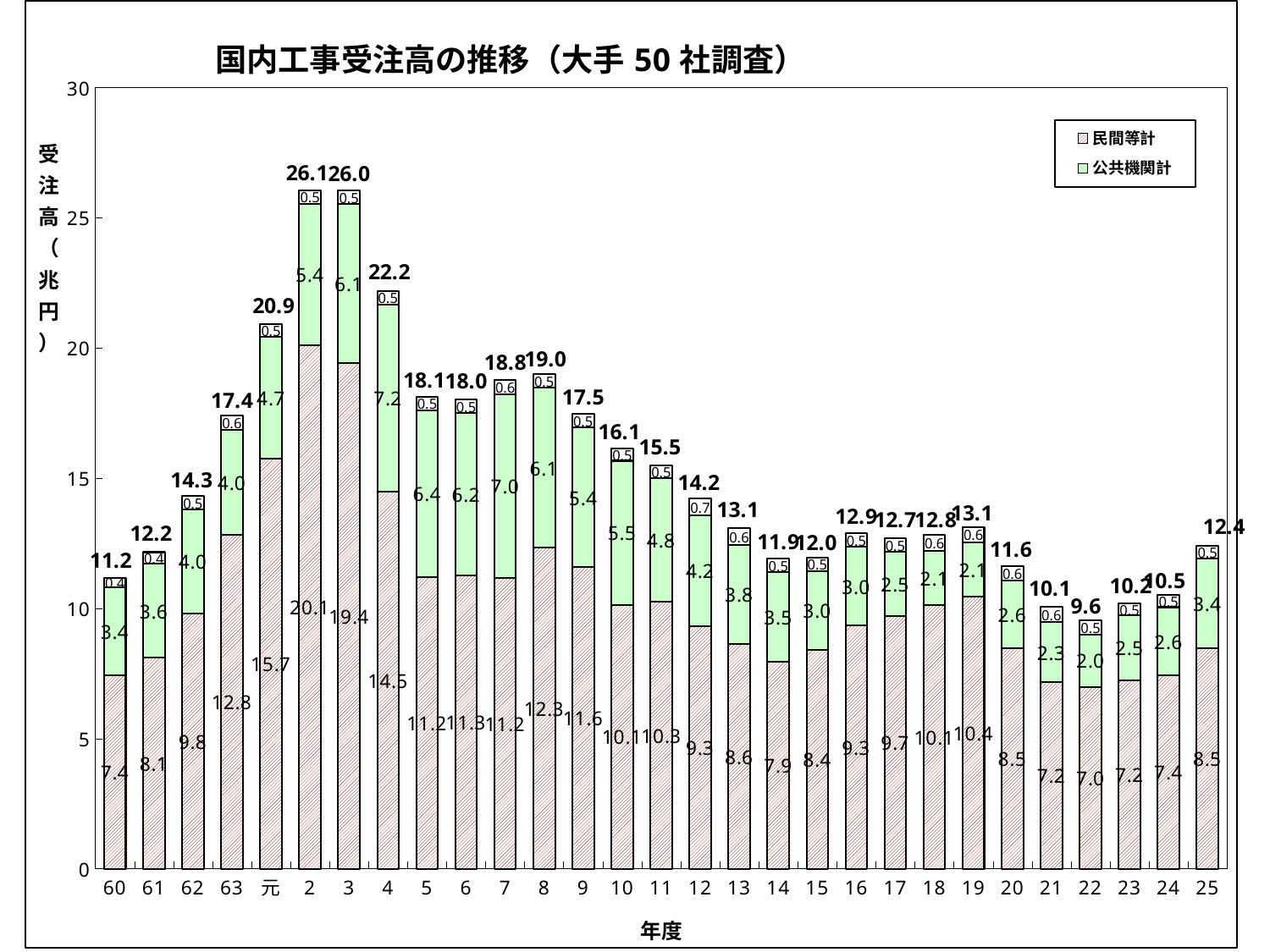
Which fiscal year has the lowest total order value? 22 How many fiscal years (bars) are shown on the x axis? 29 What is the 公共機関計 value for fiscal year 4? 7.2 What is the 民間等計 value for fiscal year 25? 8.5 Do the total order values generally rise or fall from fiscal year 2 to fiscal year 22? Fall How many series does the legend list? 2 What is the title of the chart? 国内工事受注高の推移（大手50社調査） Which is larger, the 民間等計 value for fiscal year 63 or for fiscal year 8? 63 What is the total order value (bar total) for fiscal year 元? 20.9 What is the difference between the total for fiscal year 2 and the total for fiscal year 22? 16.5 Which fiscal year has the highest total order value? 2 What kind of chart is shown on the slide? Stacked bar chart